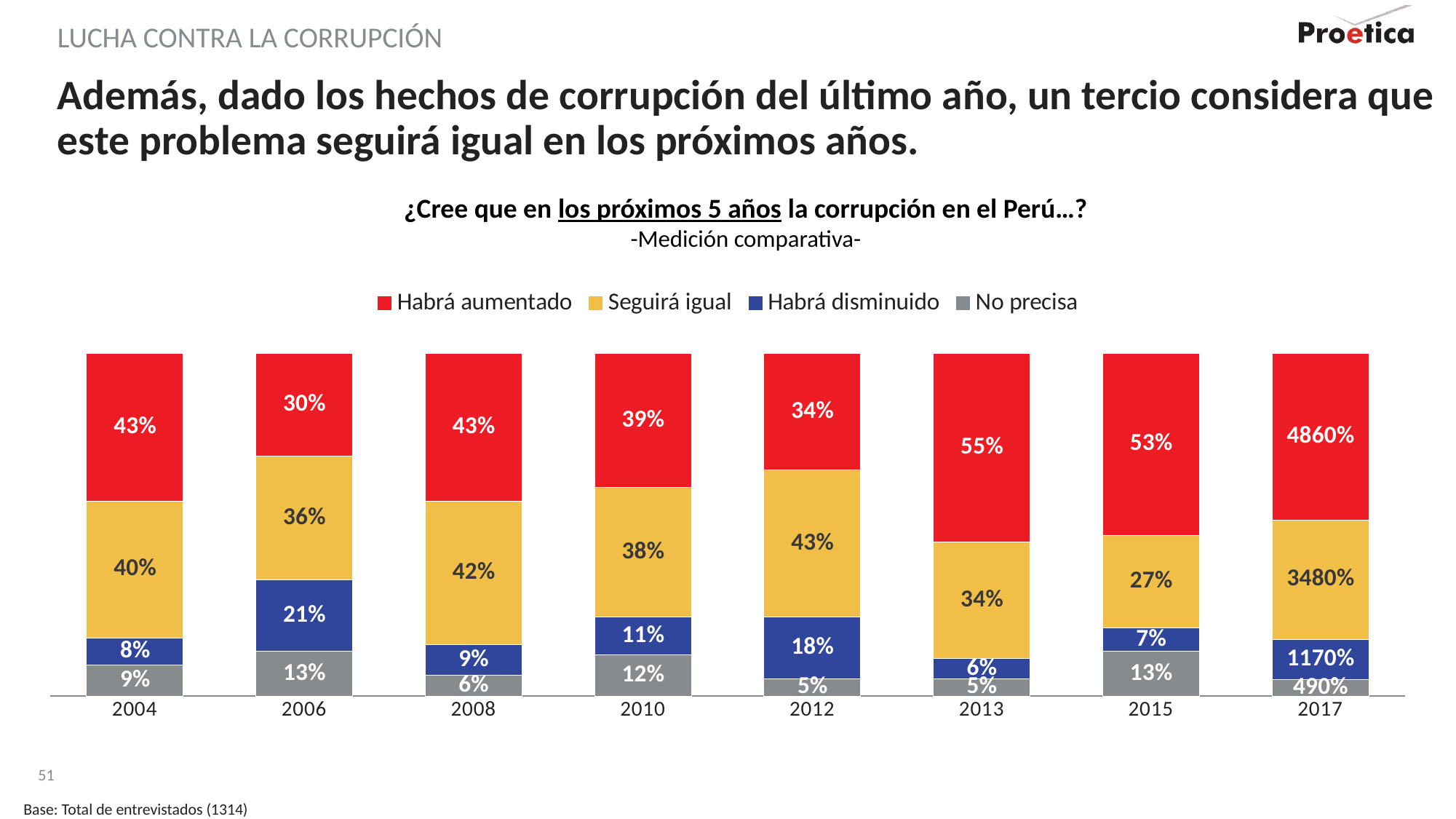
What type of chart is shown on the slide? Stacked bar chart What is the value for "No precisa" in 2010? 12% Among the years 2004 to 2015, in which year is the "Habrá disminuido" value lowest? 2013 How many years are shown on the x axis? 8 Which series is shown in red in the legend? Habrá aumentado Among the years 2004 to 2015, in which year is the "Habrá aumentado" value highest? 2013 What is the value for "Habrá disminuido" in 2006? 21% What is the difference between the "Habrá aumentado" values for 2013 and 2006? 25% What is the value for "Seguirá igual" in 2008? 42% Which is larger, the "Seguirá igual" value in 2012 or in 2015? 2012 What is the value for "Habrá aumentado" in 2013? 55% How many series does the legend list? 4